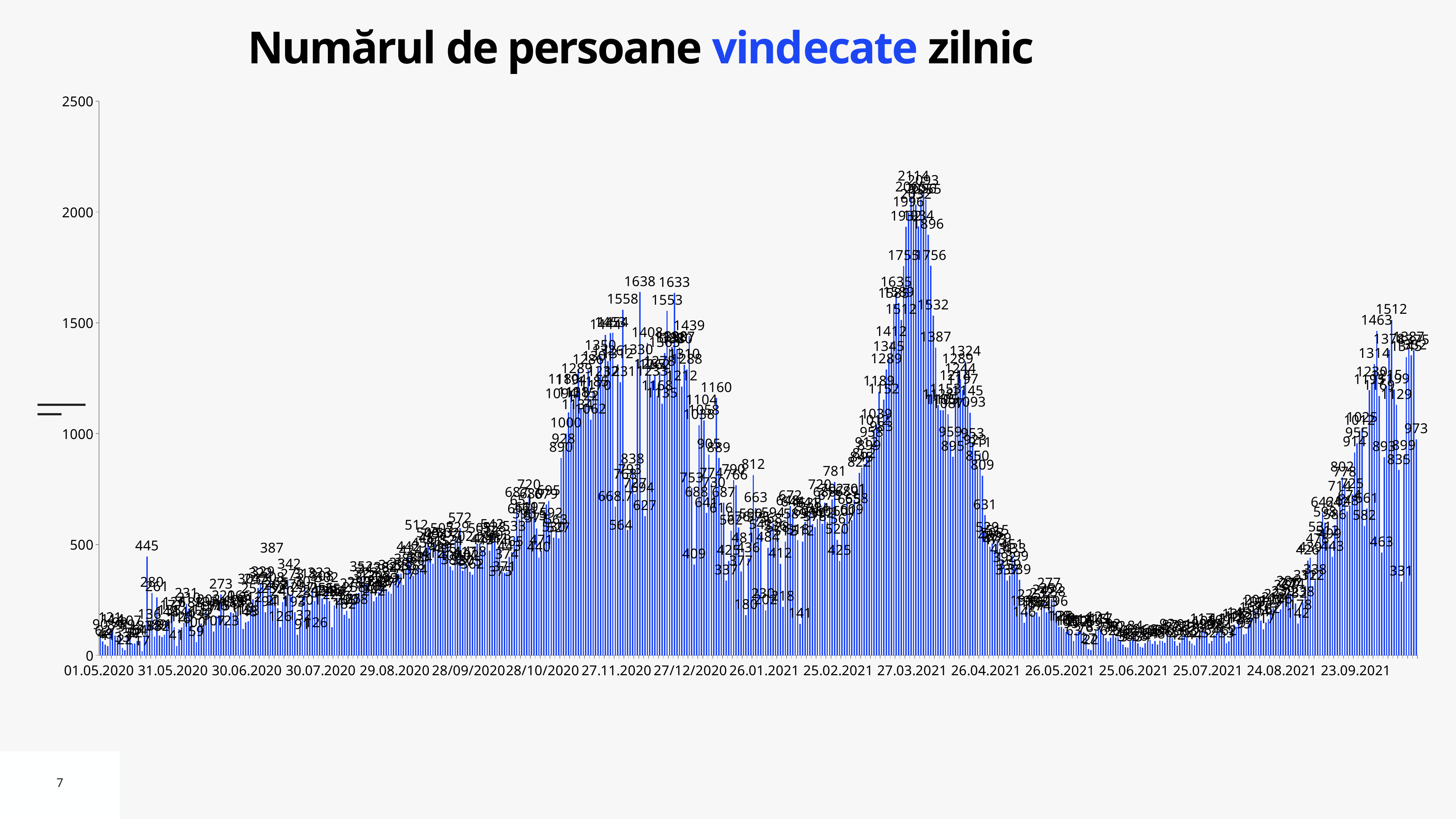
What is the value of the isolated spike just before the 31.05.2020 tick? 445 Do the values rise or fall between 26.04.2021 and 26.05.2021? fall What is the first date label on the horizontal axis? 01.05.2020 What is the value of the spike labelled just before the 30.06.2020 tick? 273 What kind of chart is shown on the slide? bar chart Is the peak value near 27.03.2021 greater or less than 2000? greater Which peak is higher: the one near 27.11.2020 or the one near 27.03.2021? the one near 27.03.2021 What is the highest tick value shown on the vertical axis? 2500 Are the values around 25.06.2021 greater or less than 500? less What is the title of the chart? Numărul de persoane vindecate zilnic Do the values rise or fall between 24.08.2021 and 23.09.2021? rise What is the highest value labelled on the chart? 2114